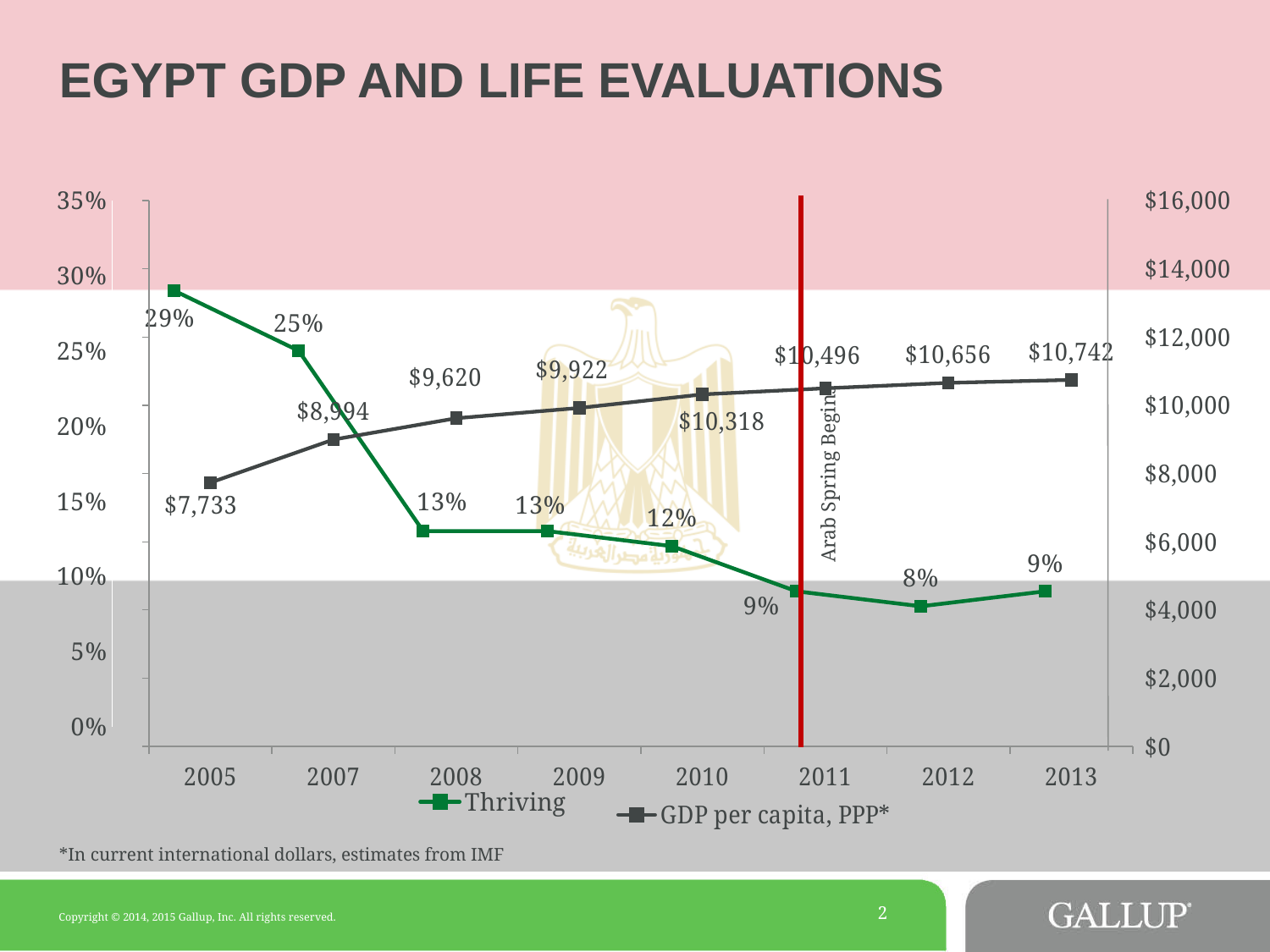
What is the difference in GDP per capita, PPP between 2013 and 2005? $3,009 How many series does the legend list? 2 What kind of chart is shown on the slide? Line chart What was the Thriving percentage in 2012? 8% What was Egypt's GDP per capita, PPP in 2013? $10,742 What was the Thriving percentage for Egypt in 2005? 29% Which year had a higher Thriving percentage, 2007 or 2010? 2007 What event does the red vertical line mark? Arab Spring Begins How many years are plotted on the x axis? 8 By how many percentage points did the Thriving percentage fall from 2005 to 2013? 20 percentage points In which year was the Thriving percentage highest? 2005 In which year was GDP per capita, PPP lowest? 2005